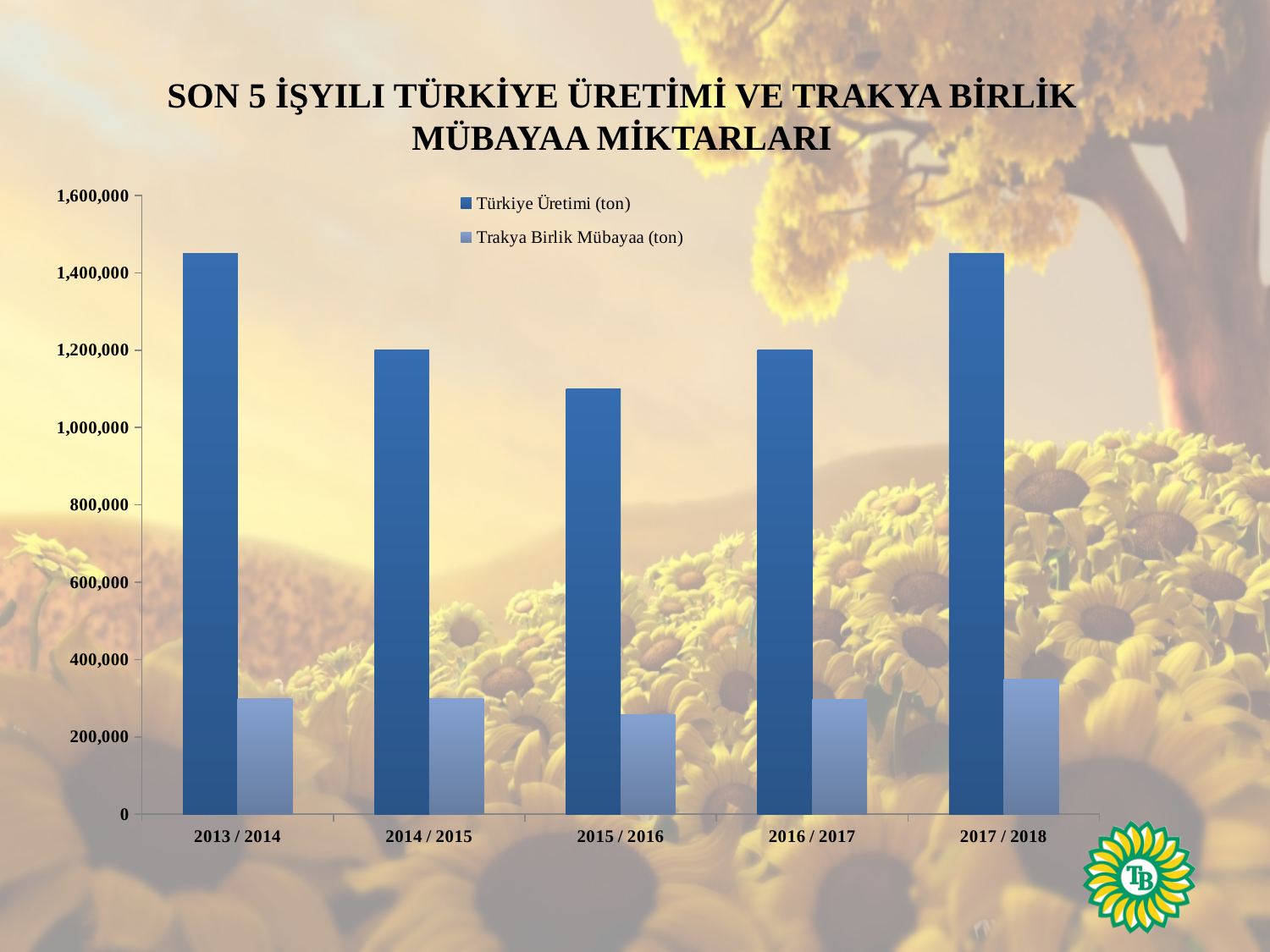
Which is larger, the Türkiye Üretimi (ton) value for 2014 / 2015 or for 2015 / 2016? 2014 / 2015 Is the Türkiye Üretimi (ton) value for 2015 / 2016 greater or less than 1,200,000? less Which year has the highest Trakya Birlik Mübayaa (ton) value? 2017 / 2018 How many series does the legend list? 2 What kind of chart is shown on the slide? bar chart Is the Türkiye Üretimi (ton) value for 2013 / 2014 greater or less than 1,400,000? greater What are the two series named in the legend? Türkiye Üretimi (ton) and Trakya Birlik Mübayaa (ton) Is the Trakya Birlik Mübayaa (ton) value for 2017 / 2018 greater or less than 400,000? less Which year has the lowest Trakya Birlik Mübayaa (ton) value? 2015 / 2016 How many business years (categories) are shown on the x axis? 5 Which year has the lowest Türkiye Üretimi (ton) value? 2015 / 2016